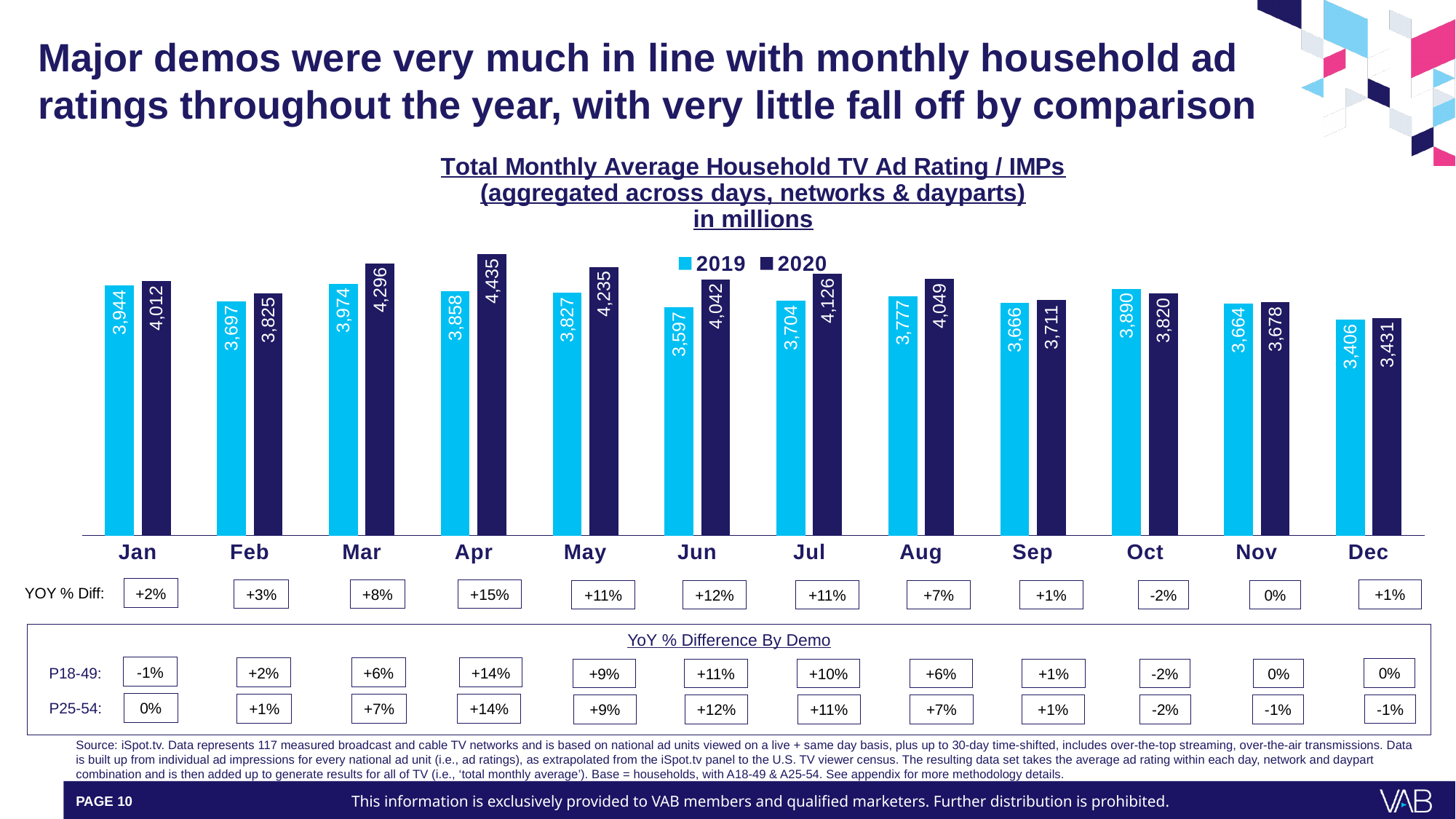
How many months are shown on the x axis? 12 What is the difference between the 2020 and 2019 values for Apr? 577 Which month has the highest 2020 value? Apr Which month has the lowest 2019 value? Dec What kind of chart is shown? Bar chart What is the 2019 value for Jun? 3,597 How many series does the legend list? 2 What is the 2020 value for Apr? 4,435 Which month has the highest 2019 value? Mar What is the 2020 value for Dec? 3,431 For Oct, which is larger: the 2019 value or the 2020 value? 2019 Which series is shown in dark navy bars? 2020